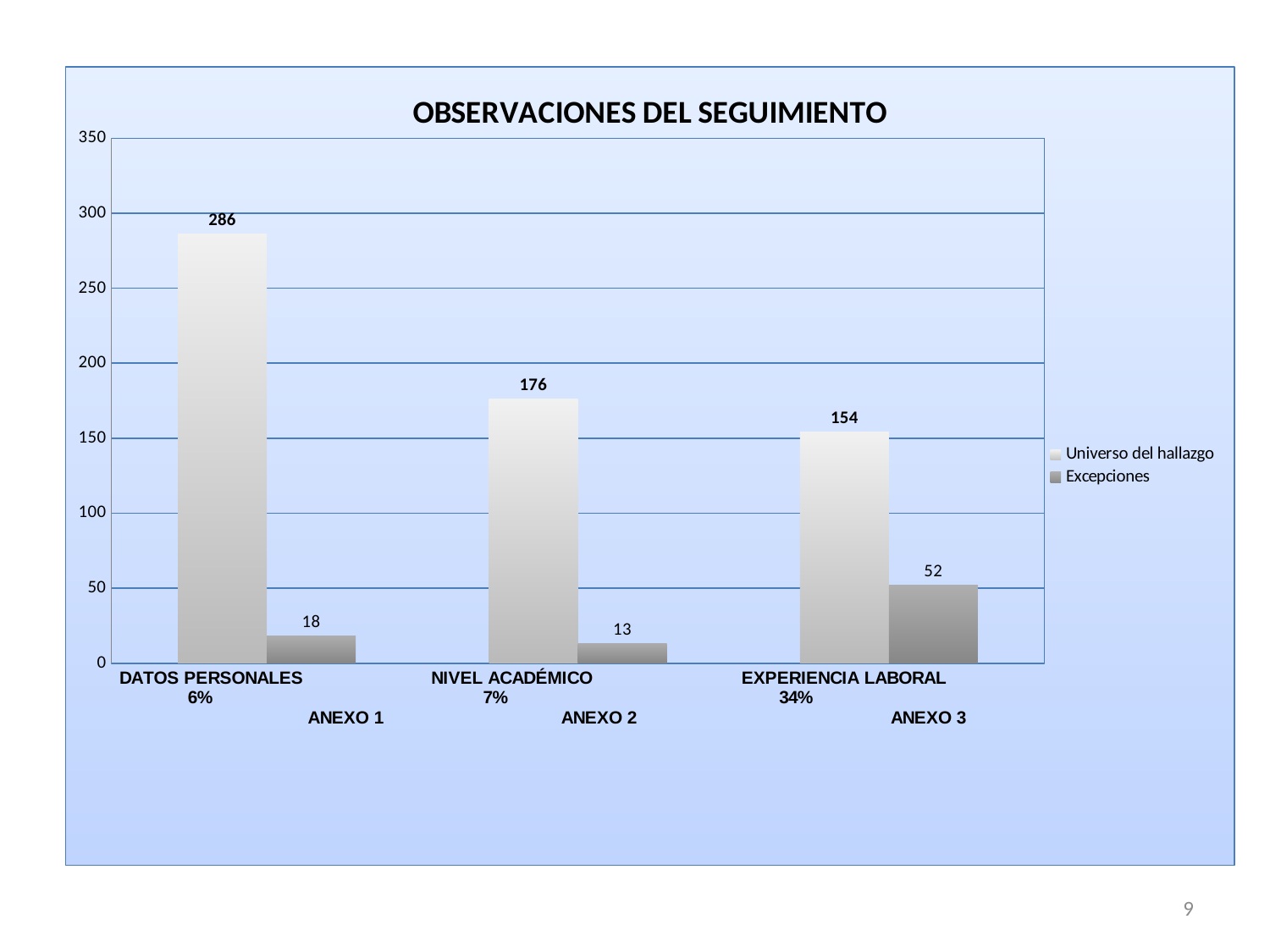
What kind of chart is shown? bar chart What is the difference between Universo del hallazgo and Excepciones for DATOS PERSONALES? 268 How many categories are shown on the x axis? 3 Is the Universo del hallazgo value for EXPERIENCIA LABORAL greater or less than 200? less What is the value of Excepciones for EXPERIENCIA LABORAL? 52 What is the value of Excepciones for NIVEL ACADÉMICO? 13 What is the value of Universo del hallazgo for DATOS PERSONALES? 286 Which category has the highest Universo del hallazgo value? DATOS PERSONALES Which is larger: Universo del hallazgo for NIVEL ACADÉMICO or for EXPERIENCIA LABORAL? NIVEL ACADÉMICO Which category has the lowest Excepciones value? NIVEL ACADÉMICO What is the title of the chart? OBSERVACIONES DEL SEGUIMIENTO How many series does the legend list? 2